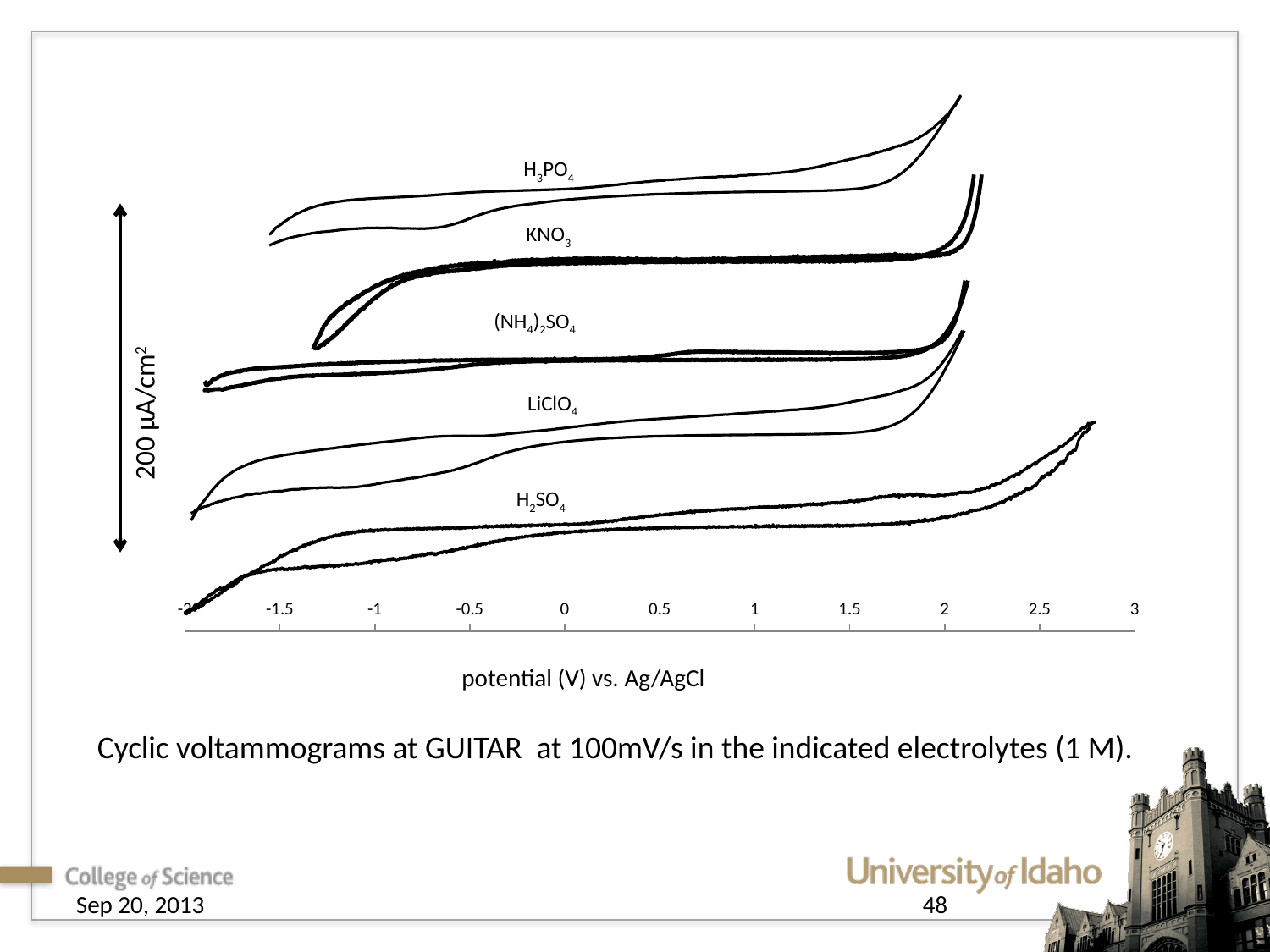
What kind of chart is shown on the slide? line chart Which curve extends to a more positive potential, H2SO4 or LiClO4? H2SO4 Is the most negative potential of the KNO3 curve greater or less than -1? less What is the highest tick value shown on the x axis? 3 Which electrolyte's curve is plotted at the top of the chart? H3PO4 Which electrolyte's curve is plotted at the bottom of the chart? H2SO4 Is the most negative potential of the H3PO4 curve greater or less than -2? greater Is the maximum potential reached by the KNO3 curve greater or less than 2.5? less How many electrolytes are labeled on the chart? 5 Which electrolyte's curve extends to the highest potential on the x axis? H2SO4 What is the label of the x axis? potential (V) vs. Ag/AgCl